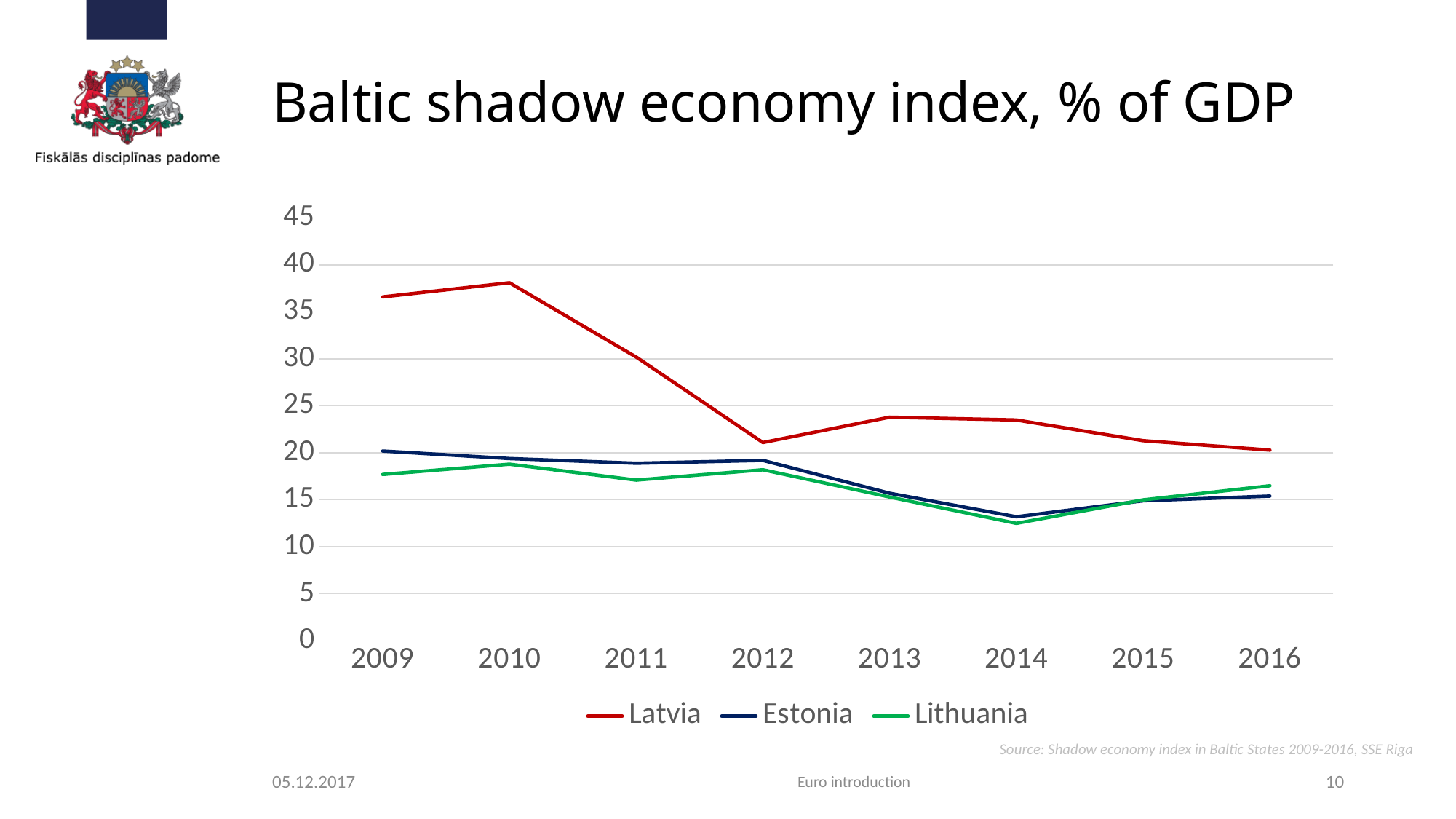
Does the Latvia line rise or fall between 2010 and 2012? fall Is the value for Latvia in 2012 greater or less than 25? less Is the value for Latvia in 2010 greater or less than 35? greater How many years are shown on the x axis? 8 Which is larger for Latvia: the value in 2009 or the value in 2010? 2010 Which country has the highest shadow economy index in 2012? Latvia Is the value for Lithuania in 2009 greater or less than 20? less Which country has the lowest shadow economy index in 2009? Lithuania How many series does the legend list? 3 In which year does the Latvia line reach its highest value? 2010 What kind of chart is shown on the slide? line chart